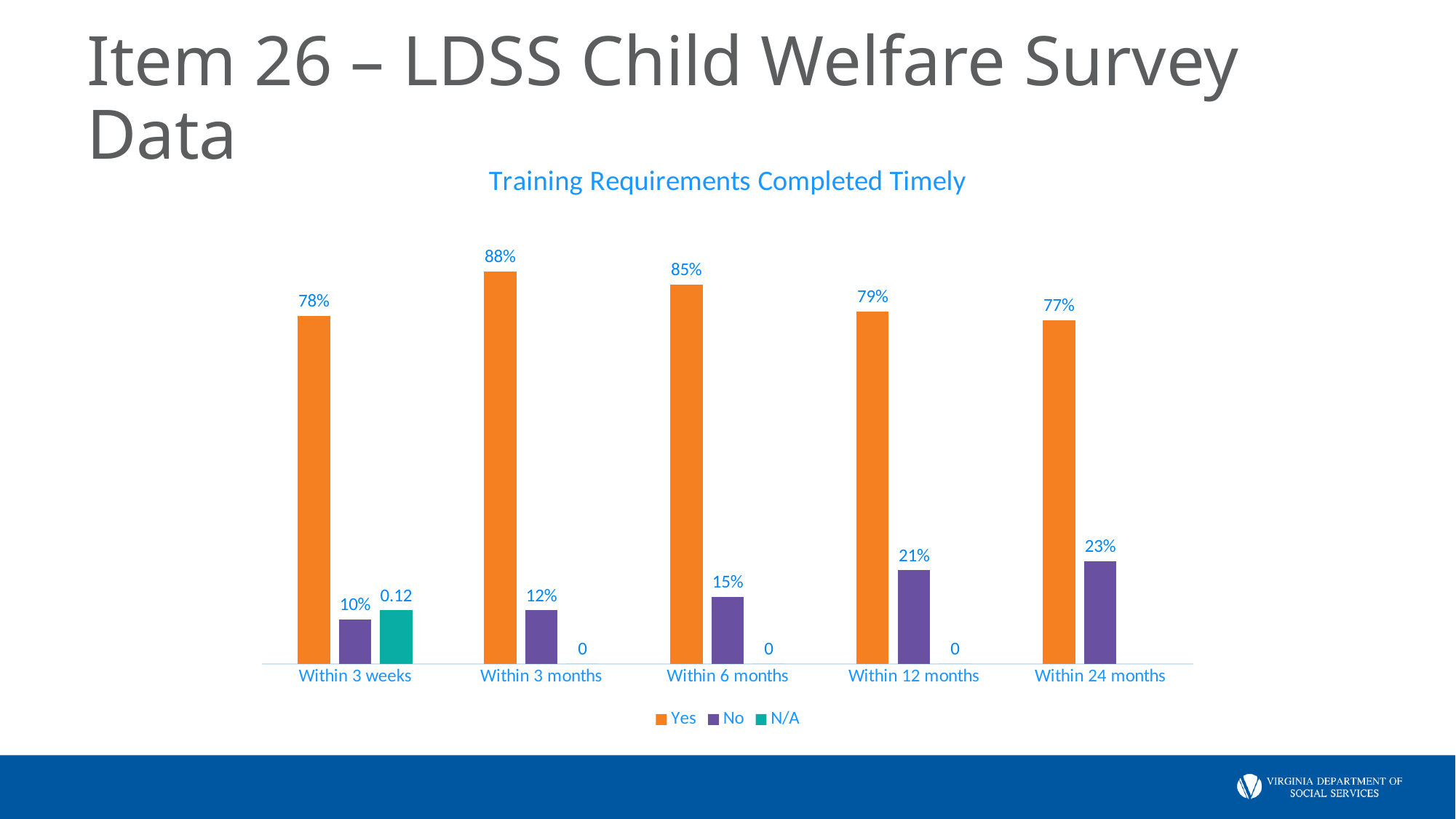
Which is larger, the No value for Within 12 months or the No value for Within 6 months? Within 12 months How many series does the legend list? 3 How many categories are shown on the x axis? 5 What is the value of the Yes series for Within 3 months? 88% What is the title of the chart? Training Requirements Completed Timely What is the value of the N/A series for Within 3 weeks? 0.12 Which category has the lowest No value? Within 3 weeks Which category has the highest Yes value? Within 3 months What kind of chart is shown? Bar chart What is the value of the No series for Within 24 months? 23% What is the difference between the Yes values for Within 6 months and Within 12 months? 6% What is the N/A value for Within 12 months? 0